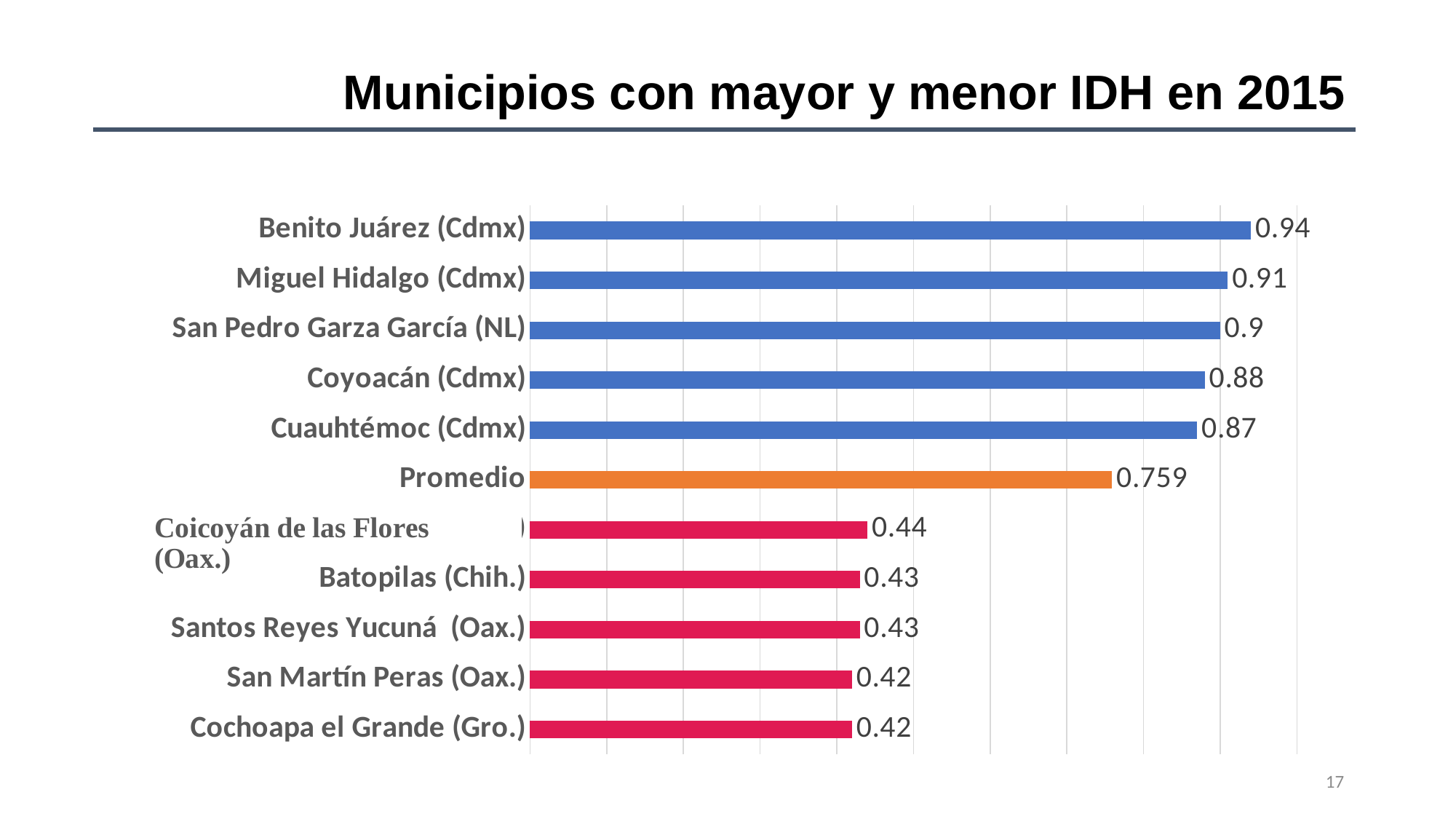
Which is larger, the value for Batopilas (Chih.) or the value for Coicoyán de las Flores (Oax.)? Coicoyán de las Flores (Oax.) What is the title of the chart? Municipios con mayor y menor IDH en 2015 Which municipality has the highest IDH value on the chart? Benito Juárez (Cdmx) What is the IDH value shown for Benito Juárez (Cdmx)? 0.94 What is the value for Coicoyán de las Flores (Oax.)? 0.44 What is the difference between the value for Benito Juárez (Cdmx) and the Promedio value? 0.181 How many bars are plotted on the chart? 11 Which is larger, the value for Coyoacán (Cdmx) or the value for Cuauhtémoc (Cdmx)? Coyoacán (Cdmx) What kind of chart is shown on the slide? Bar chart What value is shown for Promedio? 0.759 What is the value for San Pedro Garza García (NL)? 0.9 What is the difference between the values for Benito Juárez (Cdmx) and Cochoapa el Grande (Gro.)? 0.52